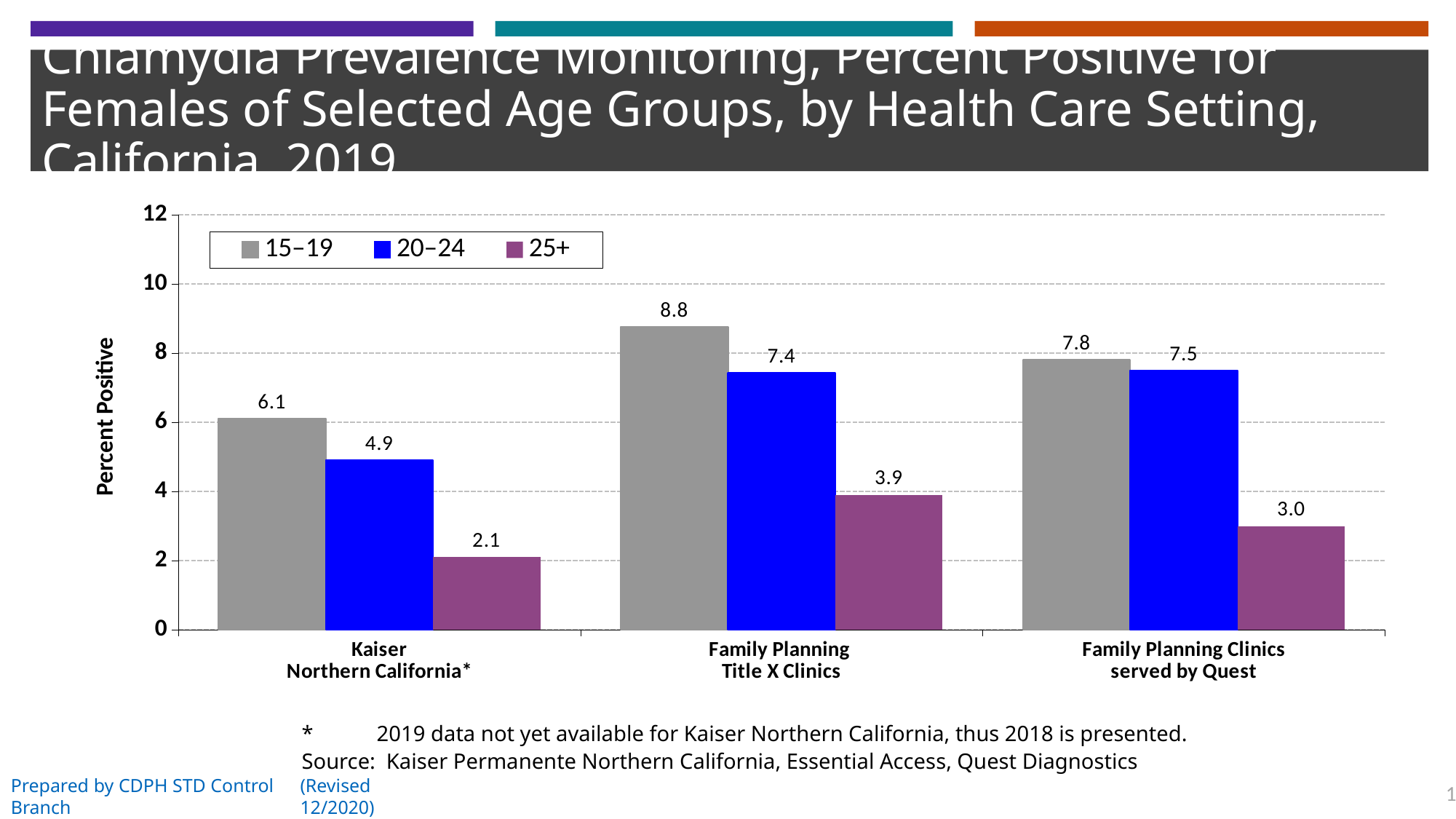
Which health care setting has the lowest percent positive for the 25+ age group? Kaiser Northern California What kind of chart is shown on the slide? Bar chart How many health care settings are shown on the x axis? 3 What is the difference between the 15–19 and 20–24 percent positive values at Kaiser Northern California? 1.2 Which is larger: the 20–24 value at Family Planning Title X Clinics or the 20–24 value at Family Planning Clinics served by Quest? Family Planning Clinics served by Quest What is the difference between the 25+ values at Family Planning Title X Clinics and Family Planning Clinics served by Quest? 0.9 What is the percent positive for the 25+ age group at Kaiser Northern California? 2.1 What is the percent positive for the 15–19 age group at Family Planning Title X Clinics? 8.8 What is the label of the y axis? Percent Positive How many age groups does the legend list? 3 What is the percent positive for the 20–24 age group at Family Planning Clinics served by Quest? 7.5 Which health care setting has the highest percent positive for the 15–19 age group? Family Planning Title X Clinics